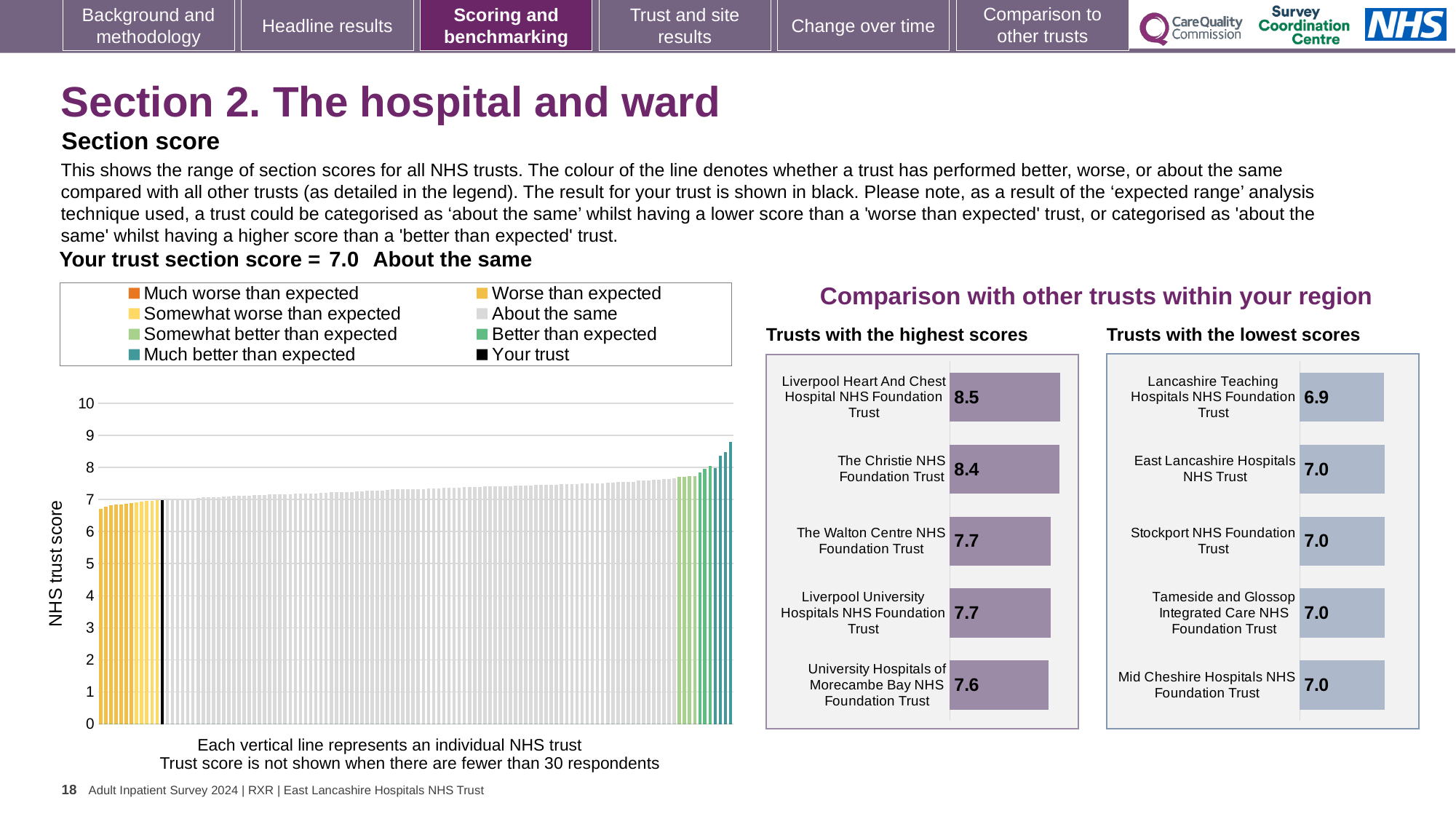
In the 'Trusts with the lowest scores' chart, how many trusts are shown? 5 In the 'Trusts with the lowest scores' chart, what is the score for Lancashire Teaching Hospitals NHS Foundation Trust? 6.9 What kind of chart is the main chart of NHS trust scores on the left? Bar chart In the main chart of NHS trust scores on the left, do the values rise or fall from left to right along the x axis? Rise In the 'Trusts with the highest scores' chart, what is the score for The Christie NHS Foundation Trust? 8.4 In the 'Trusts with the highest scores' chart, which trust has the lowest score? University Hospitals of Morecambe Bay NHS Foundation Trust Which is larger: the score for The Walton Centre NHS Foundation Trust in the highest scores chart or the score for Stockport NHS Foundation Trust in the lowest scores chart? The Walton Centre NHS Foundation Trust In the 'Trusts with the highest scores' chart, what is the score for Liverpool Heart And Chest Hospital NHS Foundation Trust? 8.5 In the main chart of NHS trust scores on the left, what is the section score for your trust? 7.0 How many entries does the legend of the main chart on the left list? 8 In the 'Trusts with the highest scores' chart, what is the difference between the scores of Liverpool Heart And Chest Hospital NHS Foundation Trust and University Hospitals of Morecambe Bay NHS Foundation Trust? 0.9 In the 'Trusts with the lowest scores' chart, which trust has the lowest score? Lancashire Teaching Hospitals NHS Foundation Trust